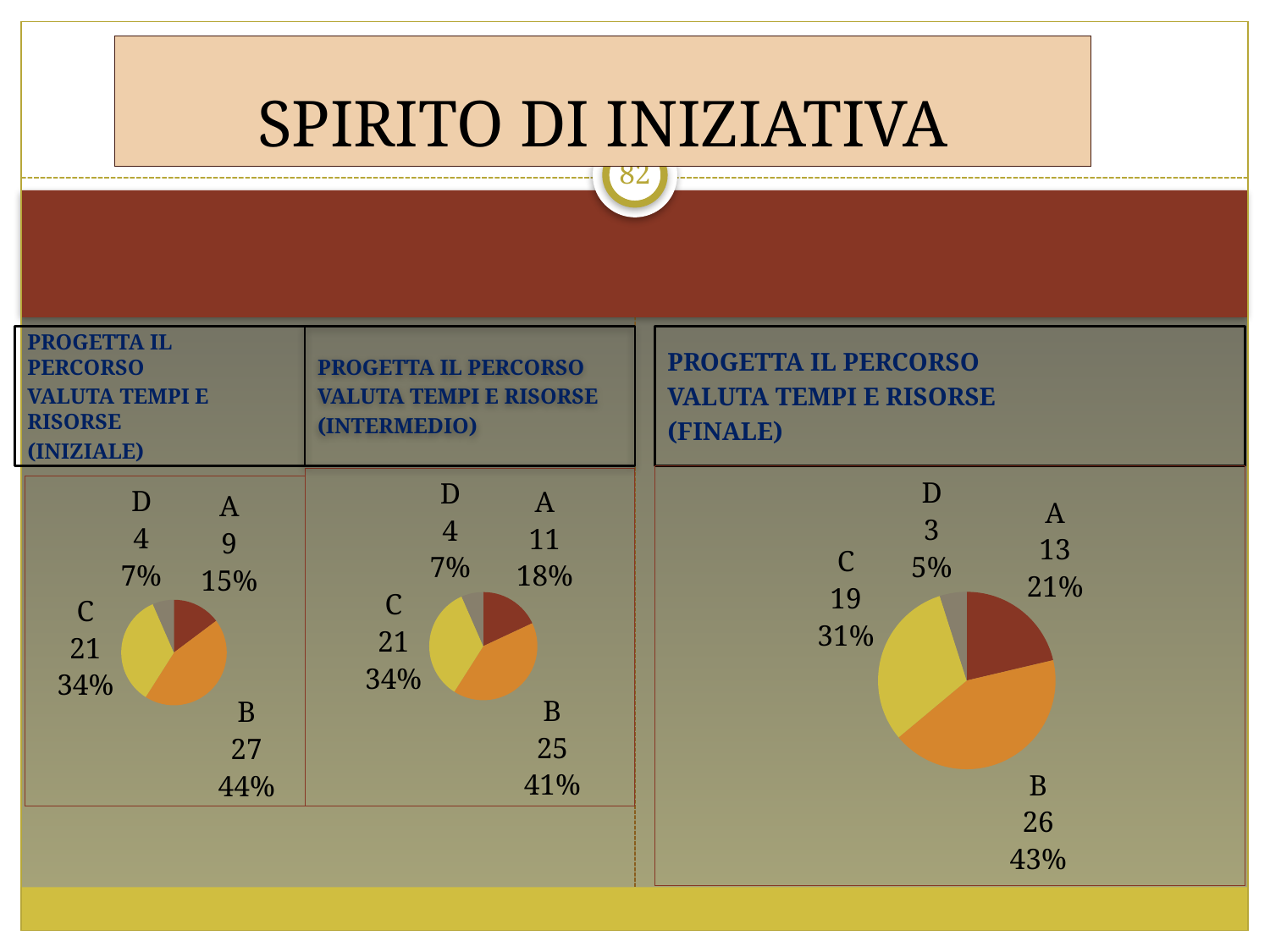
In the INTERMEDIO pie chart, which category has the largest value? B In the INIZIALE pie chart, what is the value for category B? 27 In the FINALE pie chart, what is the value for category C? 19 In the FINALE pie chart, what is the difference between the values for B and A? 13 In the INIZIALE pie chart, what share of the pie does category C represent? 34% What type of chart is used in the INIZIALE panel? Pie chart In the INIZIALE pie chart, which category has the smallest value? D In the FINALE pie chart, what percentage is shown for category D? 5% In the FINALE pie chart, which is larger, the value for A or the value for C? C In the INTERMEDIO pie chart, what percentage is shown for category B? 41% In the INTERMEDIO pie chart, what is the value for category A? 11 How many categories does the FINALE pie chart show? 4